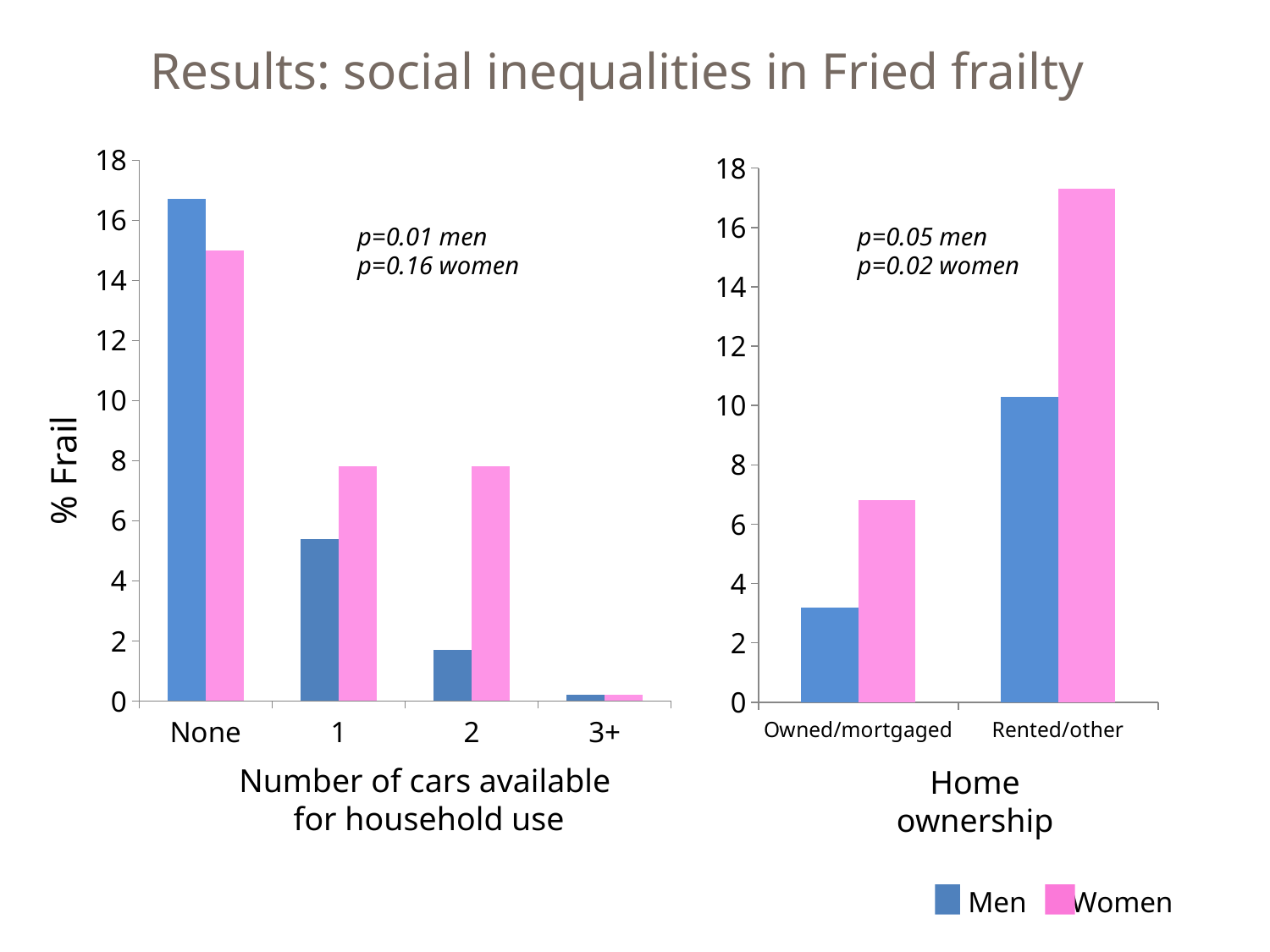
In the 'Home ownership' chart, how many categories are shown on the x axis? 2 In the 'Home ownership' chart, is the value for Women in Rented/other greater or less than 16? greater How many series does the legend list? 2 In the 'Number of cars available for household use' chart, do the values for Men rise or fall as the number of cars increases? fall In the 'Number of cars available for household use' chart, is the value for Men with no cars greater or less than 14? greater In the 'Home ownership' chart, is the value for Men in Owned/mortgaged greater or less than 4? less What kind of chart is the 'Number of cars available for household use' chart? bar chart What is the label on the y axis of the left chart? % Frail In the 'Number of cars available for household use' chart, how many categories are shown on the x axis? 4 In the 'Number of cars available for household use' chart, which category has the highest value for Men? None In the 'Number of cars available for household use' chart, for the '1' car category, which is larger: Men or Women? Women